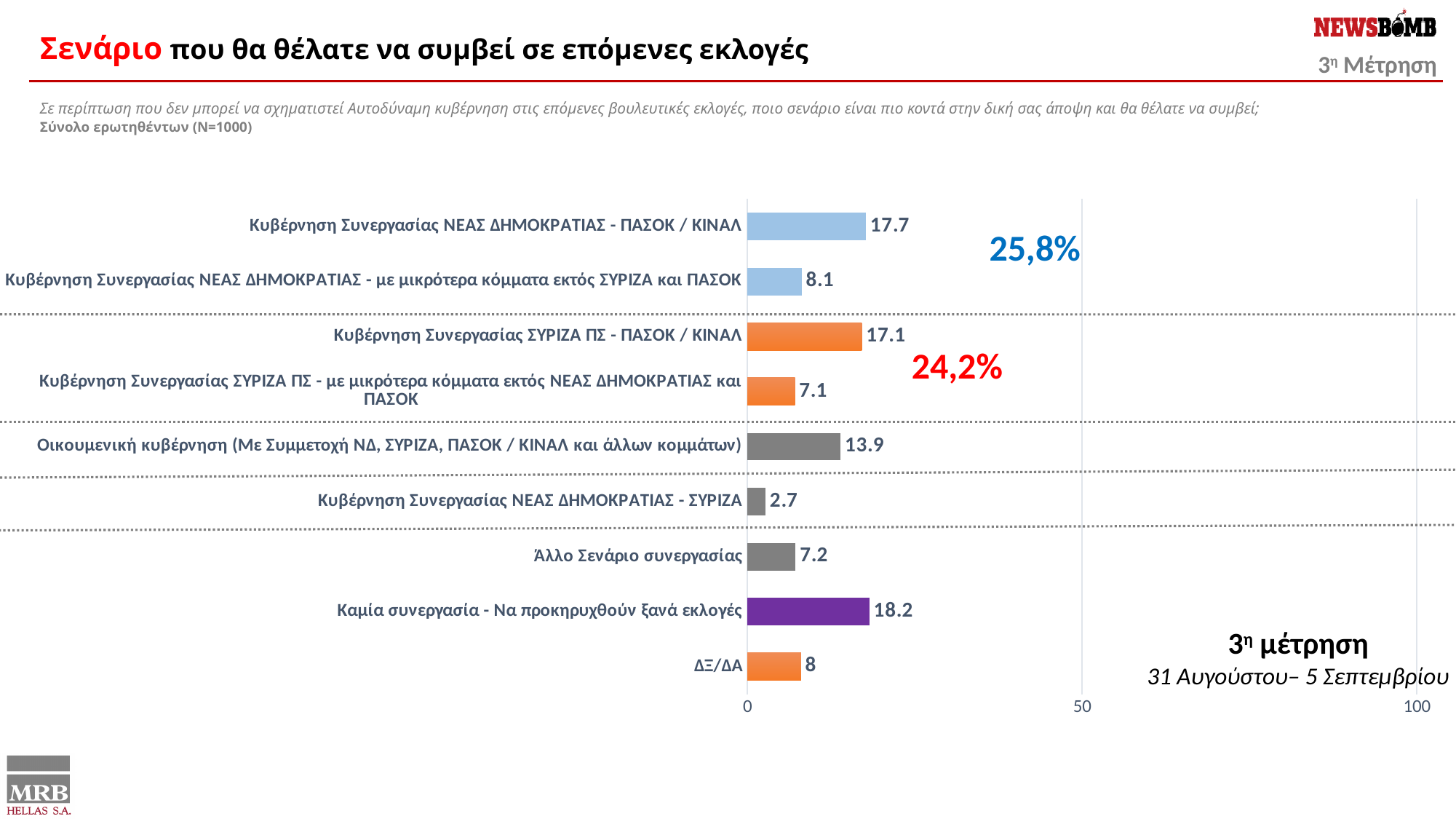
What is the value for 'ΔΞ/ΔΑ'? 8 Which is larger: the value for 'Άλλο Σενάριο συνεργασίας' or the value for 'Κυβέρνηση Συνεργασίας ΝΕΑΣ ΔΗΜΟΚΡΑΤΙΑΣ - με μικρότερα κόμματα εκτός ΣΥΡΙΖΑ και ΠΑΣΟΚ'? Κυβέρνηση Συνεργασίας ΝΕΑΣ ΔΗΜΟΚΡΑΤΙΑΣ - με μικρότερα κόμματα εκτός ΣΥΡΙΖΑ και ΠΑΣΟΚ What is the value for 'Καμία συνεργασία - Να προκηρυχθούν ξανά εκλογές'? 18.2 Which category has the highest value? Καμία συνεργασία - Να προκηρυχθούν ξανά εκλογές What type of chart is shown on the slide? bar chart What is the difference between the values for 'Κυβέρνηση Συνεργασίας ΝΕΑΣ ΔΗΜΟΚΡΑΤΙΑΣ - ΠΑΣΟΚ / ΚΙΝΑΛ' and 'Κυβέρνηση Συνεργασίας ΣΥΡΙΖΑ ΠΣ - ΠΑΣΟΚ / ΚΙΝΑΛ'? 0.6 Is the value for 'Καμία συνεργασία - Να προκηρυχθούν ξανά εκλογές' greater or less than 50? less What is the combined percentage shown for the two ΝΕΑΣ ΔΗΜΟΚΡΑΤΙΑΣ cooperation scenarios? 25,8% What is the value for 'Οικουμενική κυβέρνηση (Με Συμμετοχή ΝΔ, ΣΥΡΙΖΑ, ΠΑΣΟΚ / ΚΙΝΑΛ και άλλων κομμάτων)'? 13.9 How many categories (scenarios) are plotted in the chart? 9 What is the value for 'Κυβέρνηση Συνεργασίας ΝΕΑΣ ΔΗΜΟΚΡΑΤΙΑΣ - ΠΑΣΟΚ / ΚΙΝΑΛ'? 17.7 Which category has the lowest value? Κυβέρνηση Συνεργασίας ΝΕΑΣ ΔΗΜΟΚΡΑΤΙΑΣ - ΣΥΡΙΖΑ